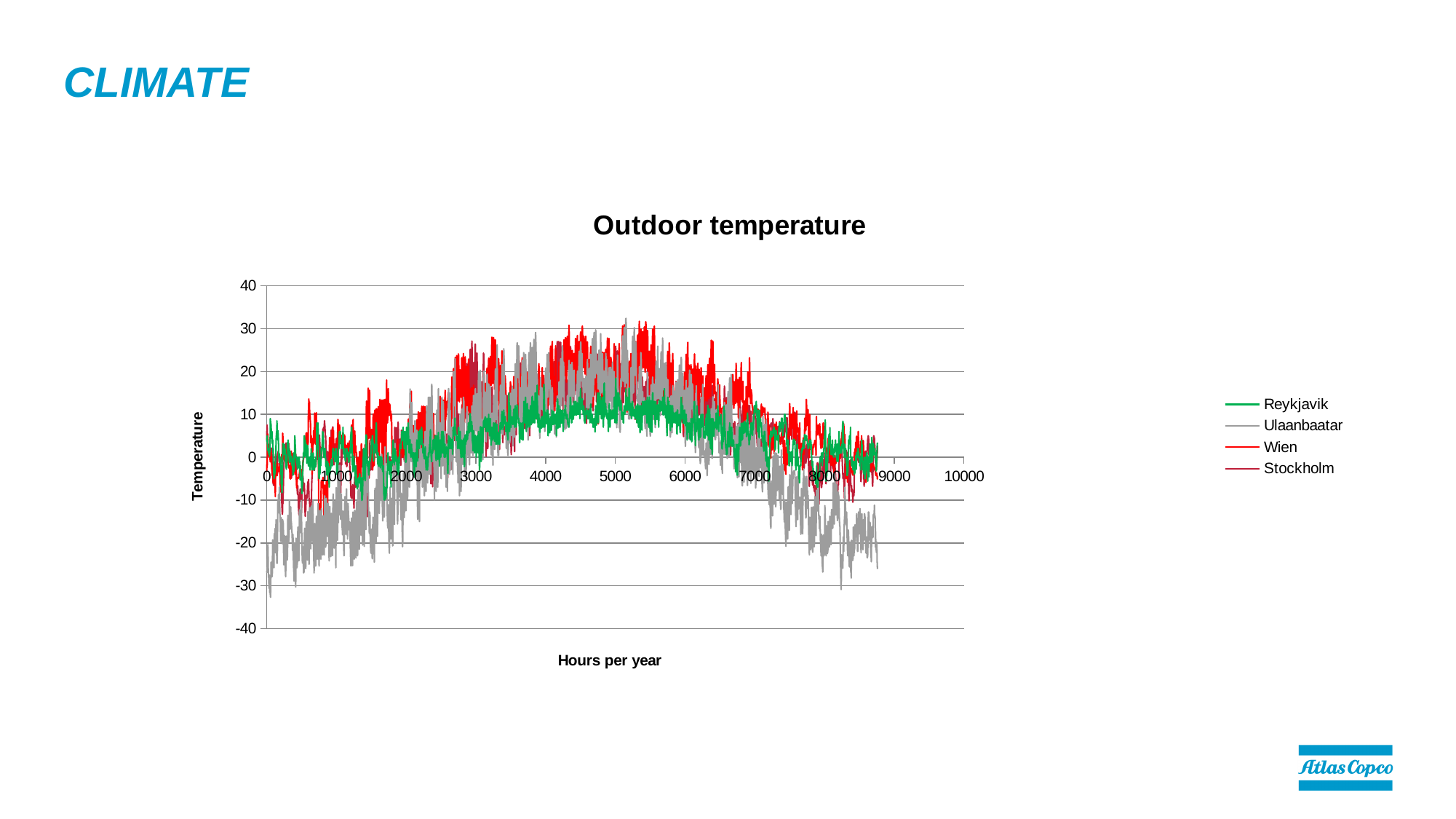
How do the temperatures change along the x axis from 0 to about 5000 hours? they rise Around 5000 hours, which series is higher, Wien or Reykjavik? Wien How many series does the legend of the Outdoor temperature chart list? 4 What kind of chart is shown on the slide? line chart Is the highest value for Reykjavik greater or less than 20? less Which series reaches the lowest temperature in the Outdoor temperature chart? Ulaanbaatar How do the temperatures change along the x axis from about 5000 to 8760 hours? they fall Is the highest value for Wien greater or less than 20? greater Which series is drawn in green in the Outdoor temperature chart? Reykjavik Which series has the smaller temperature range over the year, Reykjavik or Ulaanbaatar? Reykjavik What is the title of the chart? Outdoor temperature Is the lowest value for Ulaanbaatar greater or less than -20? less